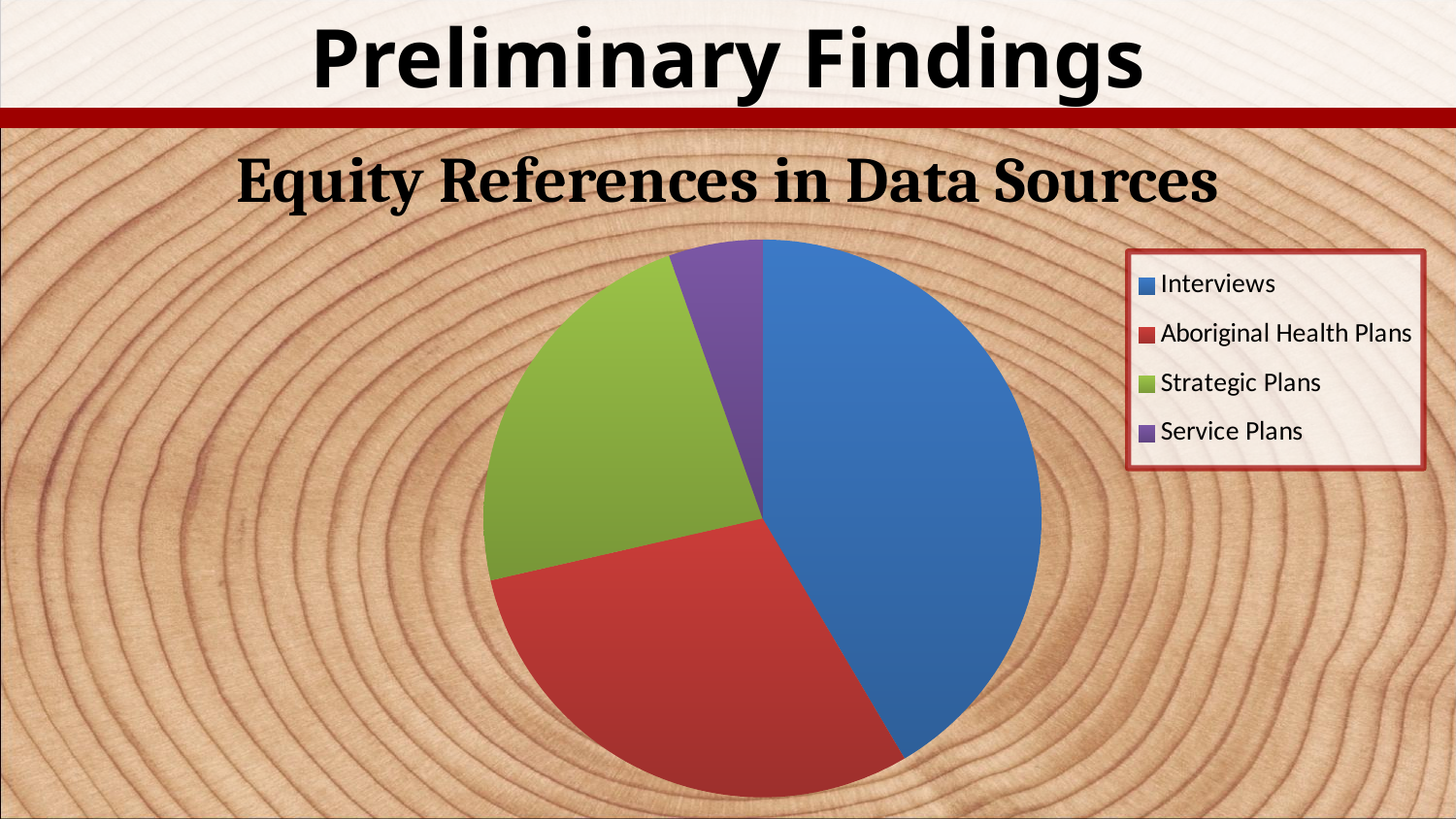
How many entries does the legend list? 4 What is the title of the chart? Equity References in Data Sources How many slices does the pie chart have? 4 Which slice is larger, Aboriginal Health Plans or Service Plans? Aboriginal Health Plans Which slice is larger, Interviews or Strategic Plans? Interviews Which slice is larger, Aboriginal Health Plans or Strategic Plans? Aboriginal Health Plans Which category has the smallest slice of the pie? Service Plans What kind of chart is shown on the slide? Pie chart Which category has the largest slice of the pie? Interviews What colour represents Strategic Plans in the pie chart? Green